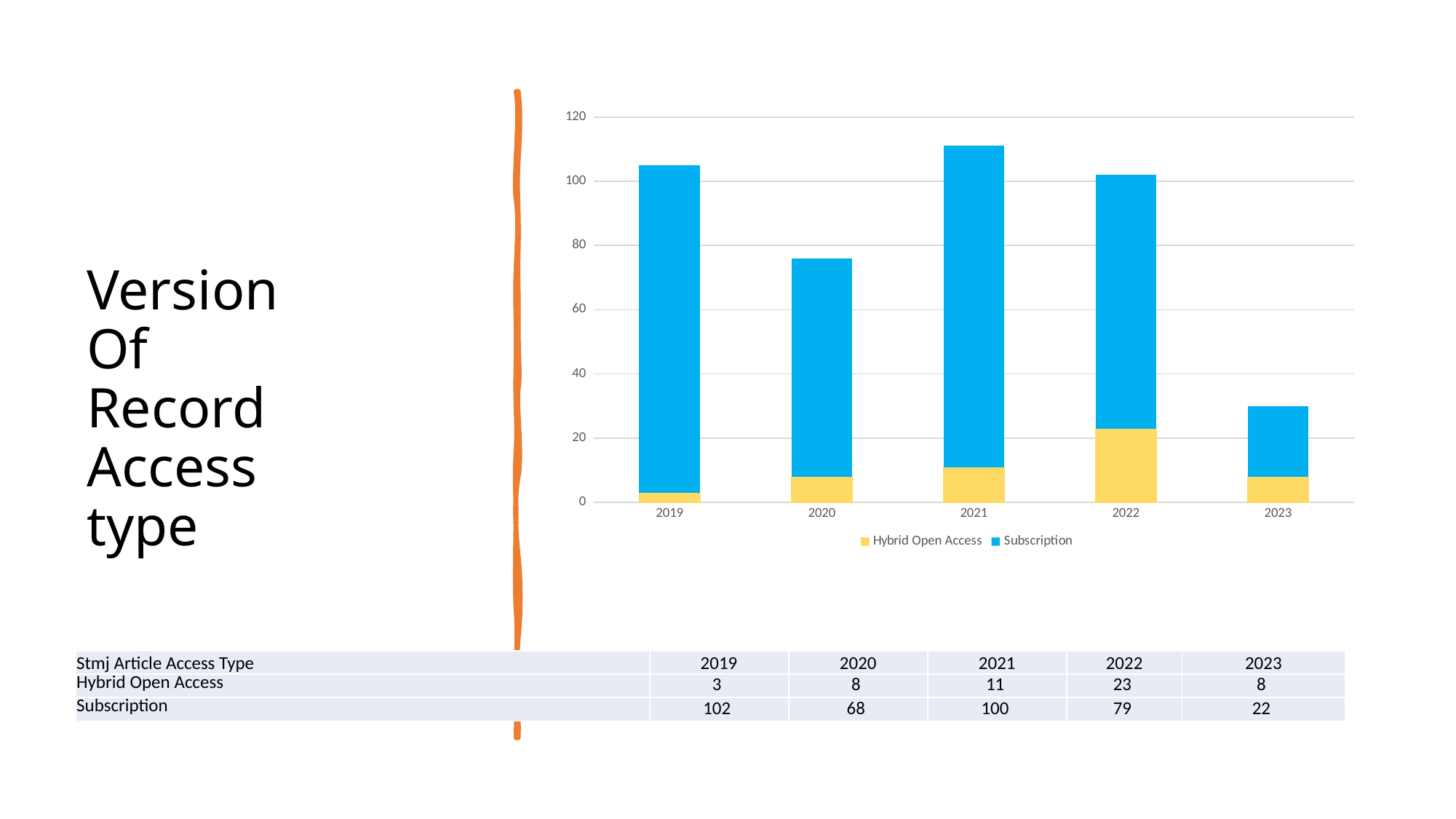
Is the total stacked bar for 2023 greater or less than 40? less Which year has the lowest Subscription value? 2023 What is the Hybrid Open Access value for 2022? 23 Which colour represents Hybrid Open Access in the chart? Yellow Which is larger, the Subscription value for 2021 or for 2022? 2021 What kind of chart is shown on the slide? Stacked bar chart What is the difference between the Subscription values for 2019 and 2020? 34 What is the Subscription value for 2019? 102 Which year has the highest Hybrid Open Access value? 2022 How many years are shown on the x axis of the chart? 5 How many series does the legend list? 2 What is the total of the stacked bar for 2021? 111